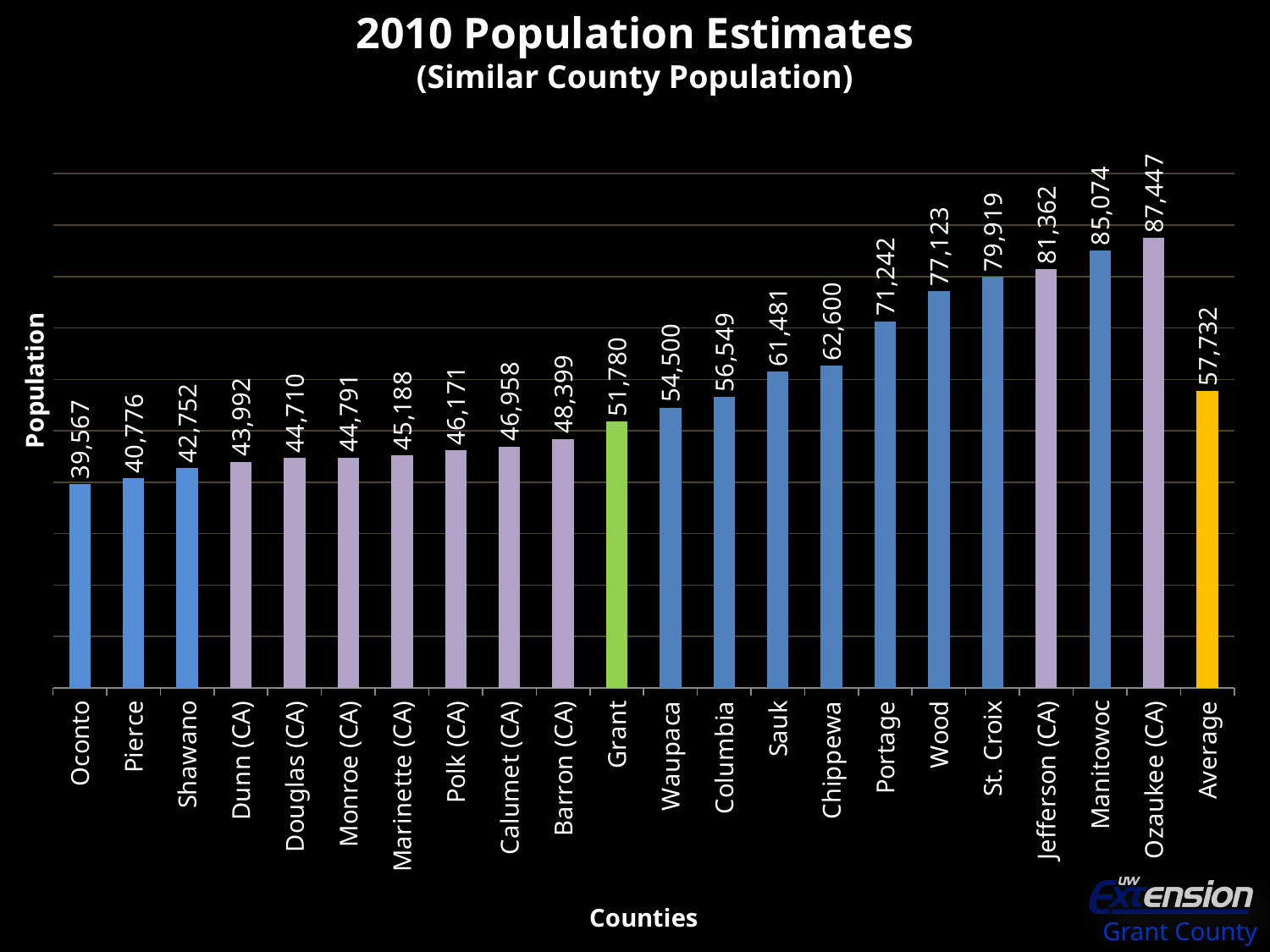
Which county has the highest population estimate? Ozaukee (CA) What is the 2010 population estimate for Grant County? 51,780 Which has a larger population estimate, Wood or Portage? Wood What type of chart is shown on the slide? Bar chart What is the difference between the population estimates of Ozaukee (CA) and Oconto? 47,880 What is the title of the chart? 2010 Population Estimates (Similar County Population) What is the population estimate for Sauk County? 61,481 What is the population estimate for Ozaukee (CA)? 87,447 Which county has the lowest population estimate? Oconto How much higher is the Average value than Grant County's population estimate? 5,952 How many bars are plotted on the chart, including the Average bar? 22 What is the value shown for the Average bar? 57,732